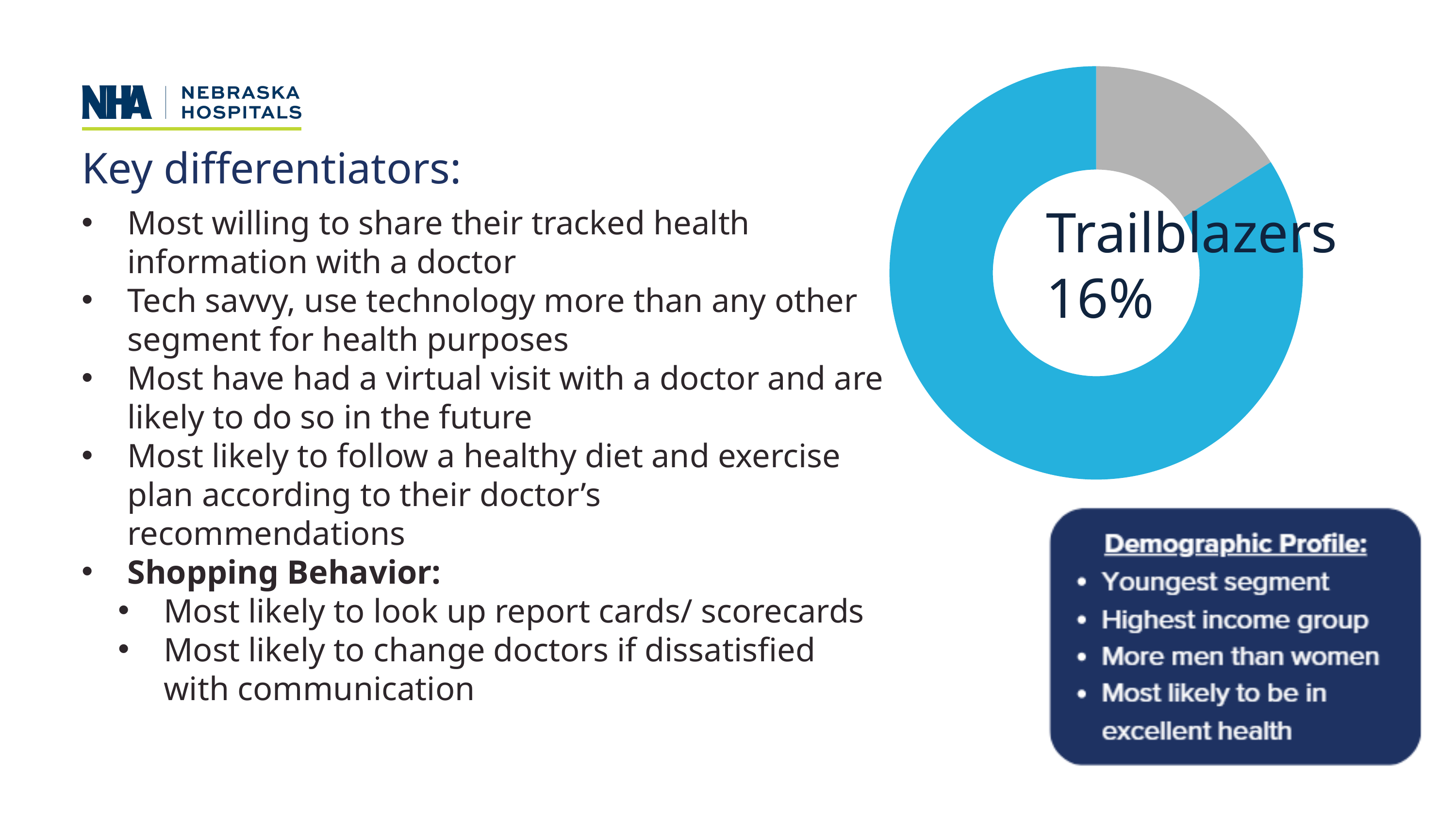
What segment name is printed in the centre of the donut chart? Trailblazers How many slices does the donut chart have? 2 Which slice of the donut chart is the smallest? The grey slice (Trailblazers, 16%) Which slice of the donut chart is larger, the blue slice or the grey slice? The blue slice What share of the donut chart is labelled for Trailblazers? 16% What kind of chart is shown on the slide? Donut chart What colour is the slice representing the Trailblazers segment in the donut chart? Grey